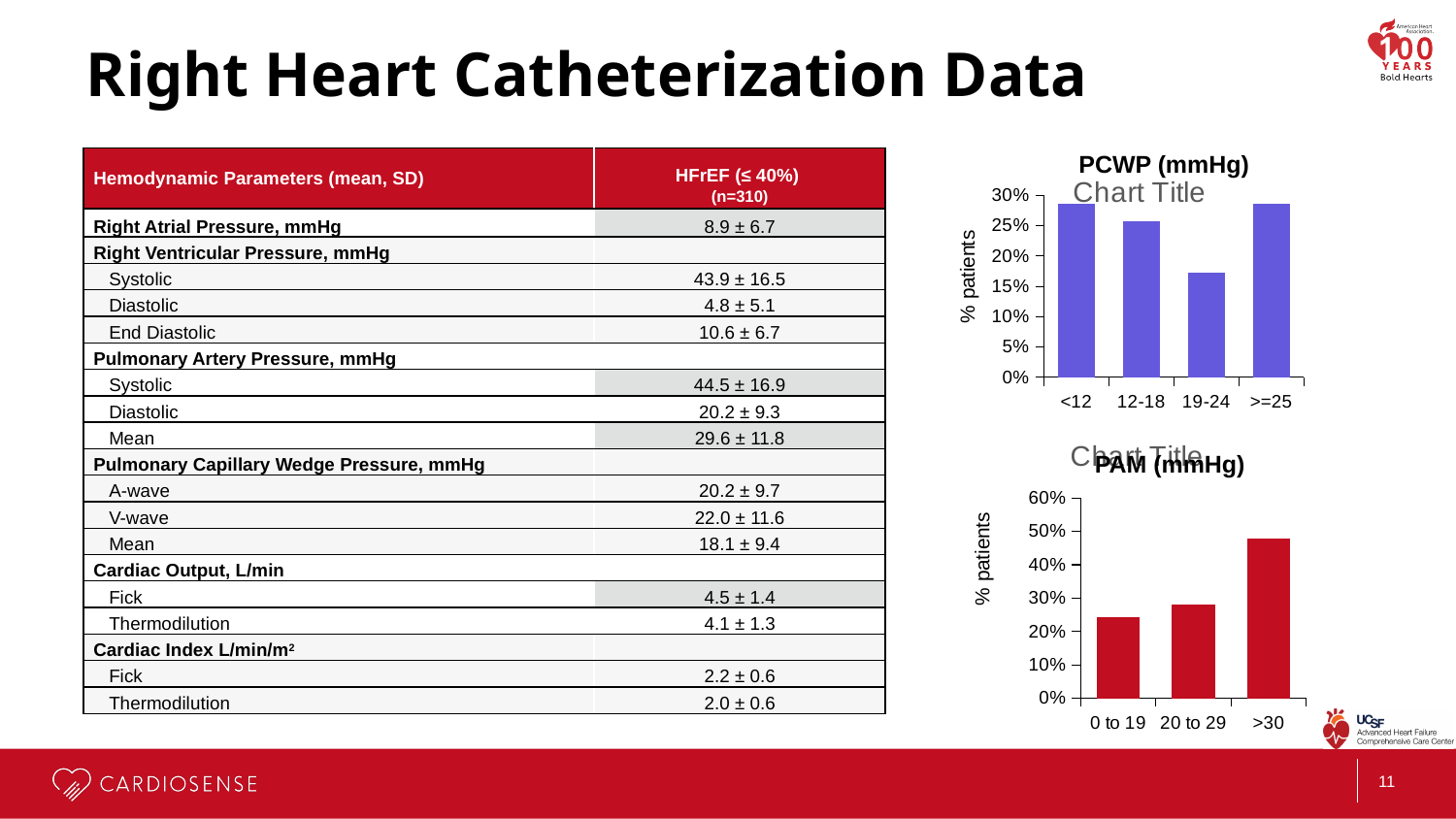
In the PAM (mmHg) chart, is the value for >30 greater or less than 40%? greater In the PAM (mmHg) chart, which category has the highest percentage of patients? >30 In the PAM (mmHg) chart, which is larger, the value for >30 or the value for 0 to 19? >30 How many categories are shown on the x axis of the PAM (mmHg) chart? 3 In the PAM (mmHg) chart, is the value for 0 to 19 greater or less than 30%? less In the PCWP (mmHg) chart, is the value for 12-18 greater or less than 20%? greater How many categories are shown on the x axis of the PCWP (mmHg) chart? 4 What kind of chart is the PCWP (mmHg) chart? bar chart In the PCWP (mmHg) chart, which category has the lowest percentage of patients? 19-24 What is the y-axis label of the PCWP (mmHg) chart? % patients